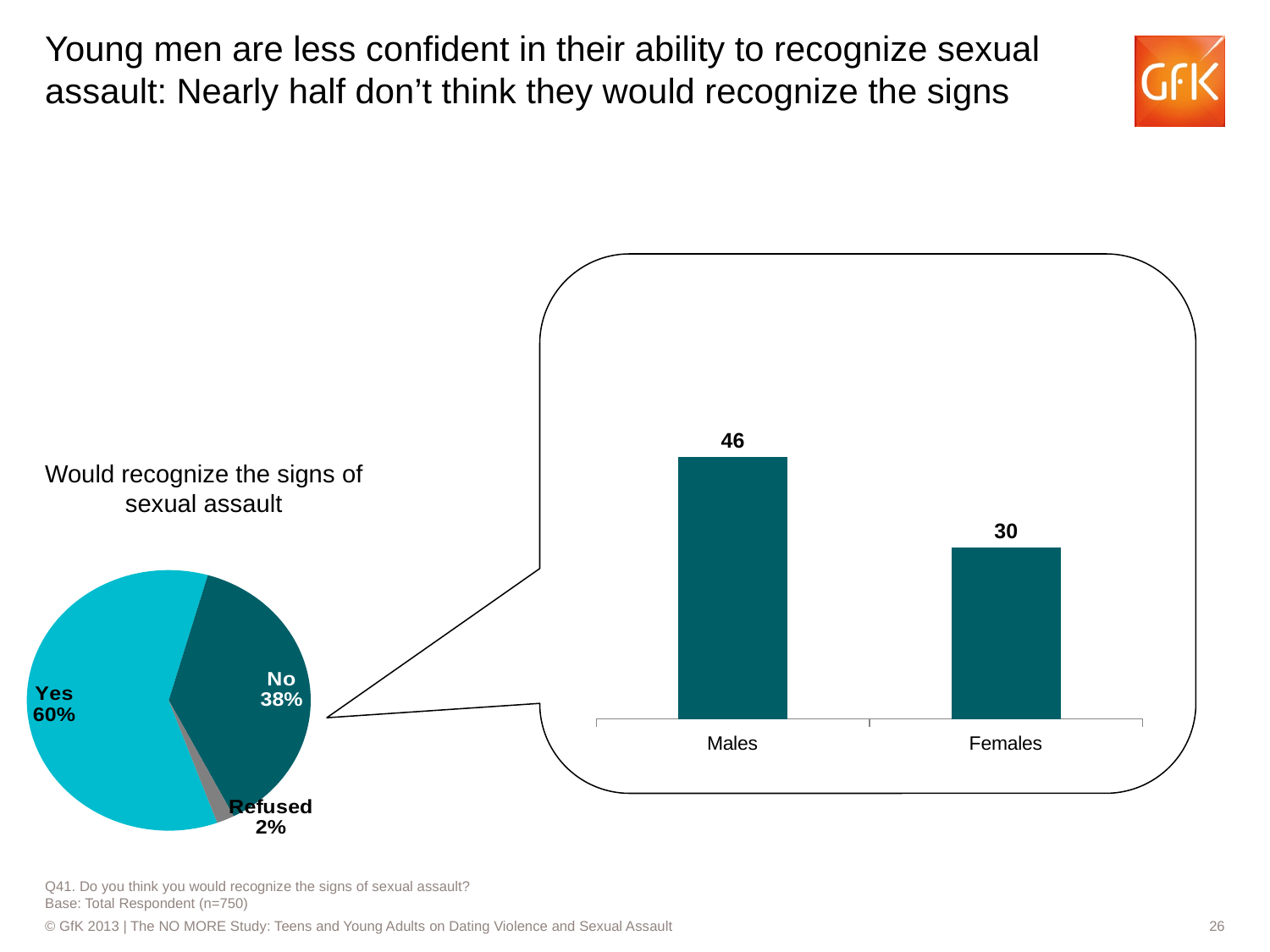
In the bar chart inside the callout on the right, what is the value for Males? 46 In the pie chart titled 'Would recognize the signs of sexual assault', what share of respondents answered Yes? 60% In the pie chart titled 'Would recognize the signs of sexual assault', what share of respondents Refused? 2% In the bar chart inside the callout on the right, what is the difference between the Males and Females values? 16 In the pie chart titled 'Would recognize the signs of sexual assault', which slice is the largest? Yes In the pie chart titled 'Would recognize the signs of sexual assault', what is the difference between the Yes and No shares? 22% In the bar chart inside the callout on the right, which category has the higher value, Males or Females? Males In the bar chart inside the callout on the right, what is the value for Females? 30 What type of chart is shown inside the callout on the right of the slide? Bar chart In the pie chart titled 'Would recognize the signs of sexual assault', how many slices are there? 3 In the pie chart titled 'Would recognize the signs of sexual assault', which slice is the smallest? Refused In the pie chart titled 'Would recognize the signs of sexual assault', what share of respondents answered No? 38%